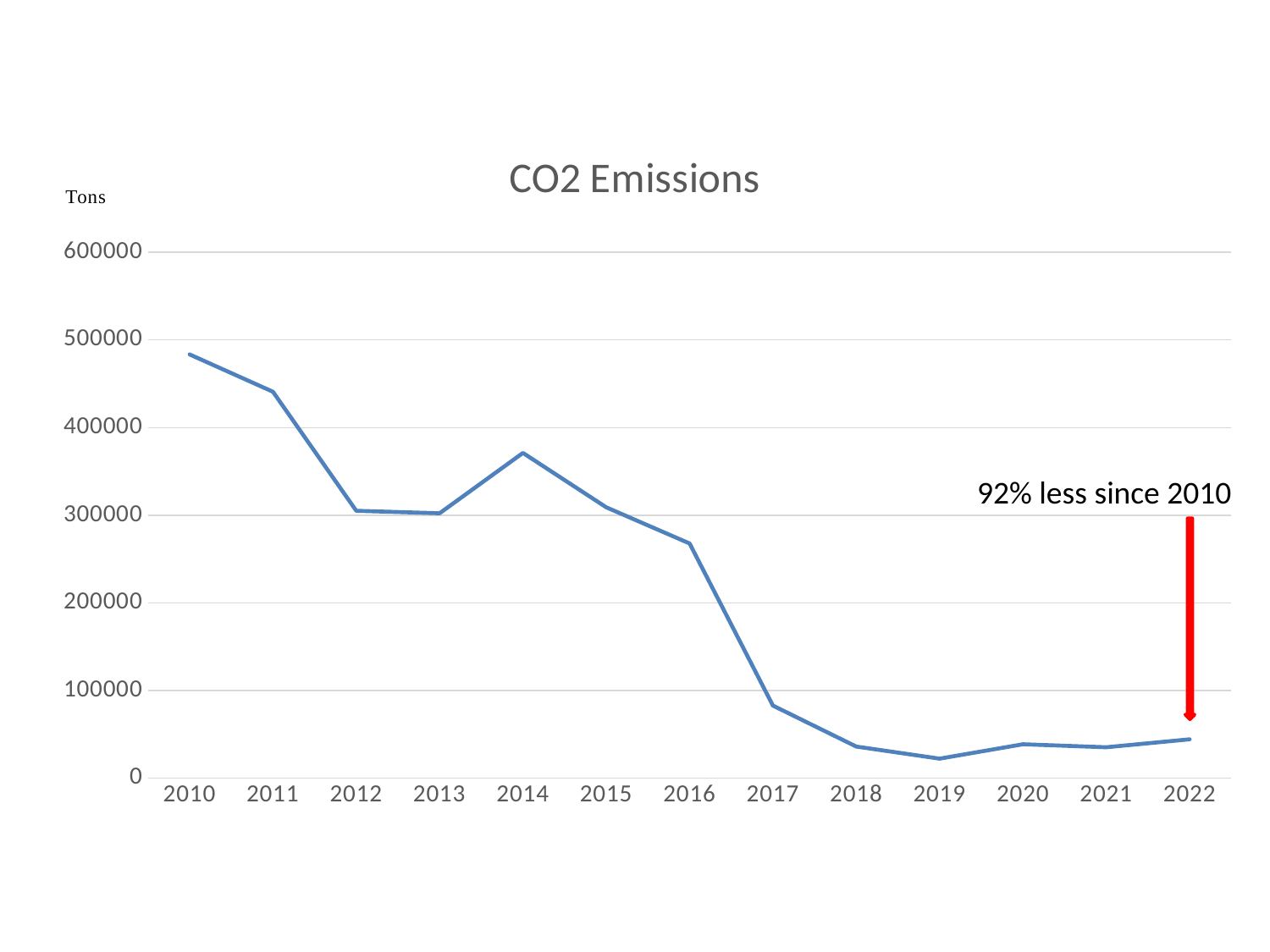
Do CO2 emissions generally rise or fall from 2010 to 2022? fall Which year has higher CO2 emissions, 2014 or 2015? 2014 Which year has the lowest CO2 emissions? 2019 What unit is shown on the vertical axis of the chart? Tons Is the value for 2014 greater or less than 300000? greater What is the title of the chart? CO2 Emissions Is the value for 2017 greater or less than 100000? less How many years are plotted on the x axis of the chart? 13 Which year has higher CO2 emissions, 2011 or 2012? 2011 Is the value for 2010 greater or less than 400000? greater What type of chart is shown on the slide? line chart Which year has the highest CO2 emissions? 2010